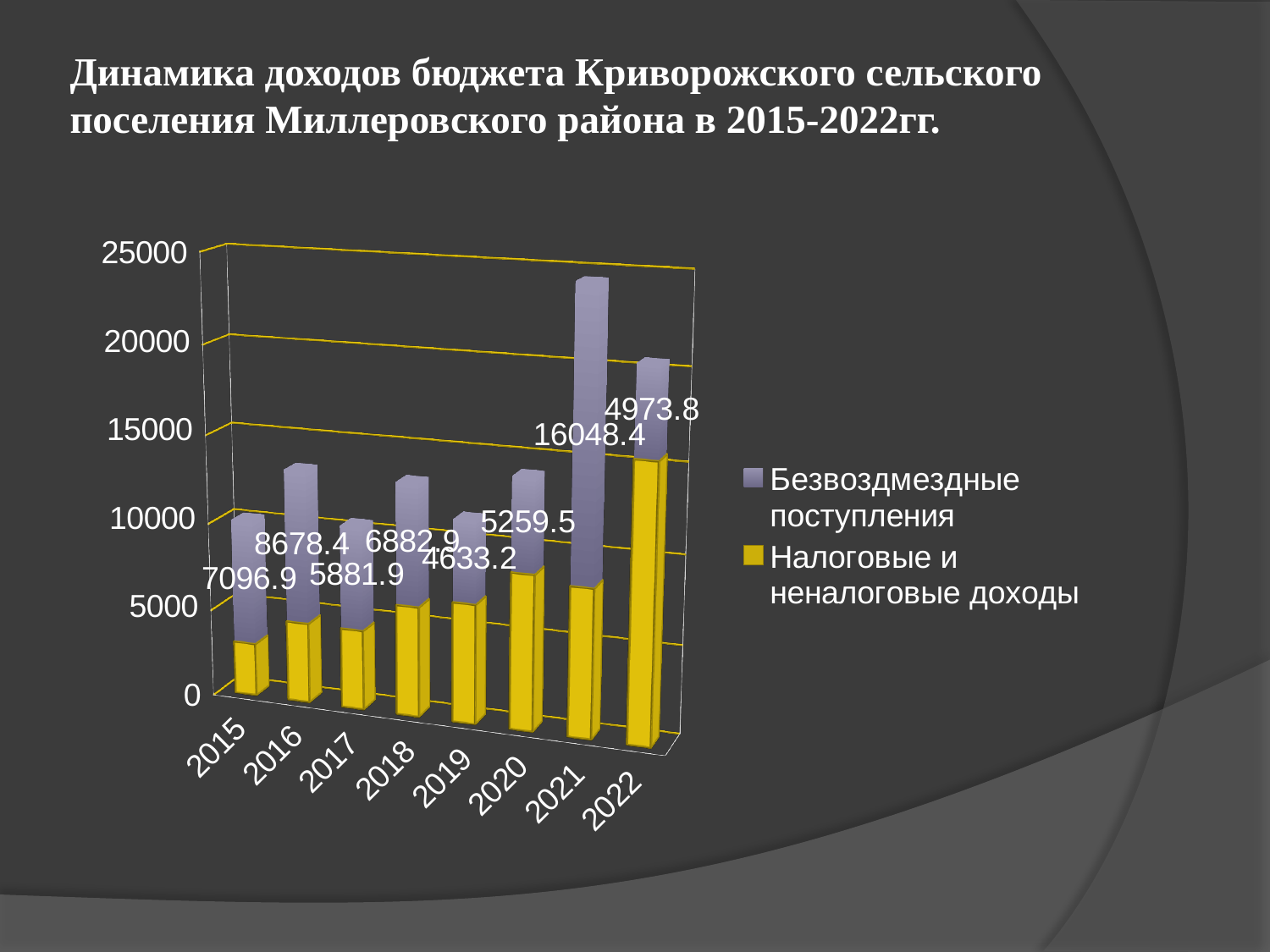
Which year has the larger value of Безвоздмездные поступления, 2016 or 2017? 2016 What kind of chart is shown on the slide? Stacked bar chart In which year is Безвоздмездные поступления highest? 2021 What is the value of Безвоздмездные поступления for 2019? 4633.2 What is the value of Безвоздмездные поступления for 2022? 4973.8 How many years are shown on the x axis? 8 What is the value of Безвоздмездные поступления for 2021? 16048.4 In which year is Безвоздмездные поступления lowest? 2019 What is the difference between Безвоздмездные поступления in 2021 and in 2015? 8951.5 How many series does the legend list? 2 What is the value of Безвоздмездные поступления for 2015? 7096.9 Is the value of Налоговые и неналоговые доходы for 2022 greater or less than 10000? greater